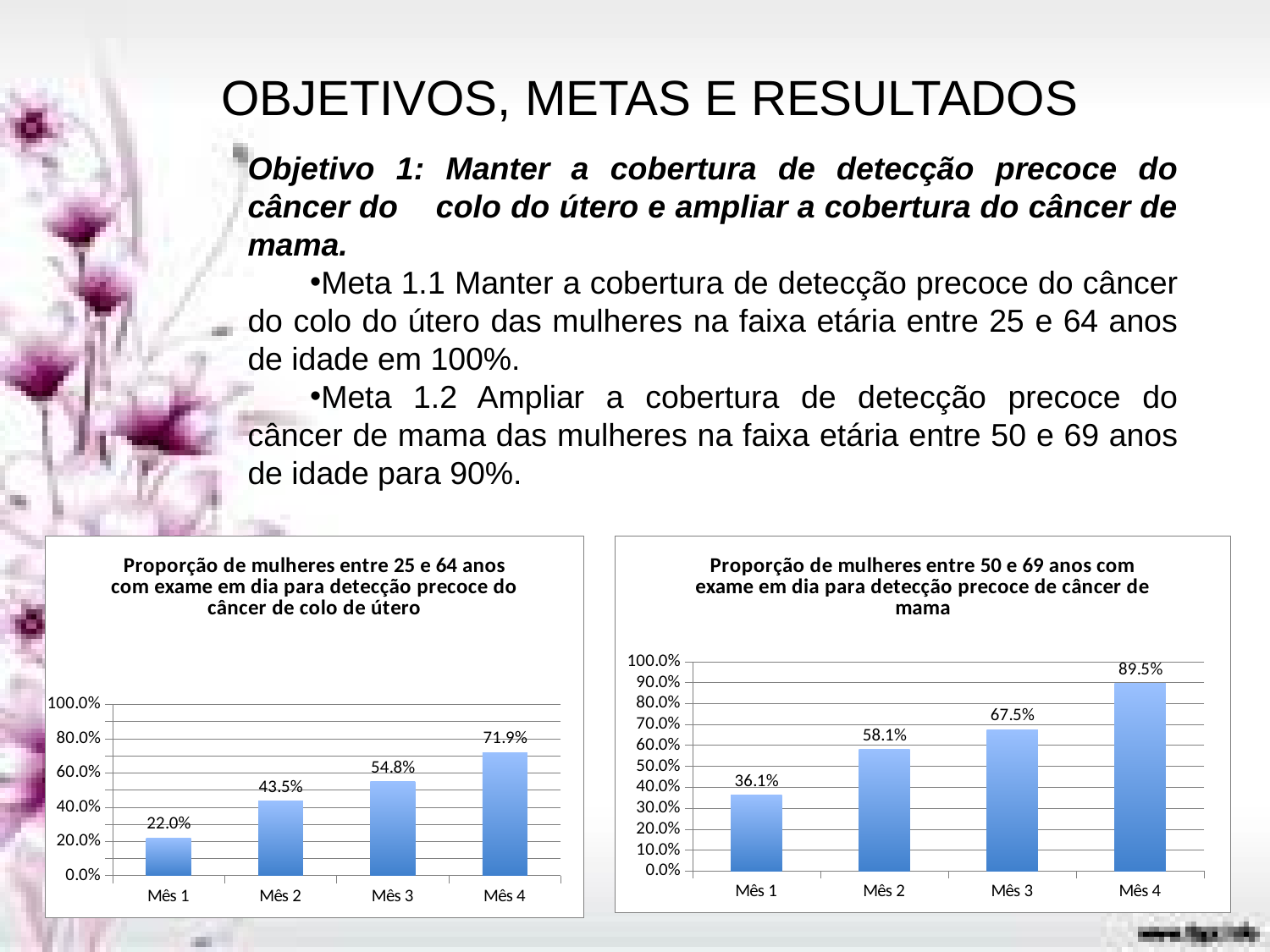
In the right chart (câncer de mama), is the value for Mês 4 greater or less than 80.0%? greater What is the title of the right chart? Proporção de mulheres entre 50 e 69 anos com exame em dia para detecção precoce de câncer de mama In the left chart (câncer de colo de útero), do the values rise or fall from Mês 1 to Mês 4? Rise In the left chart (câncer de colo de útero), what is the difference between the values for Mês 4 and Mês 1? 49.9% What kind of chart is the right chart (câncer de mama)? Bar chart How many months are plotted in the left chart (câncer de colo de útero)? 4 In the left chart (Proporção de mulheres entre 25 e 64 anos), what is the value for Mês 3? 54.8% In the left chart (câncer de colo de útero), which month has the lowest value? Mês 1 Which is larger: the value for Mês 2 in the left chart or the value for Mês 2 in the right chart? Mês 2 in the right chart In the right chart (câncer de mama), which month has the highest value? Mês 4 In the right chart (câncer de mama), what is the difference between the values for Mês 3 and Mês 2? 9.4% In the right chart (Proporção de mulheres entre 50 e 69 anos), what is the value for Mês 1? 36.1%